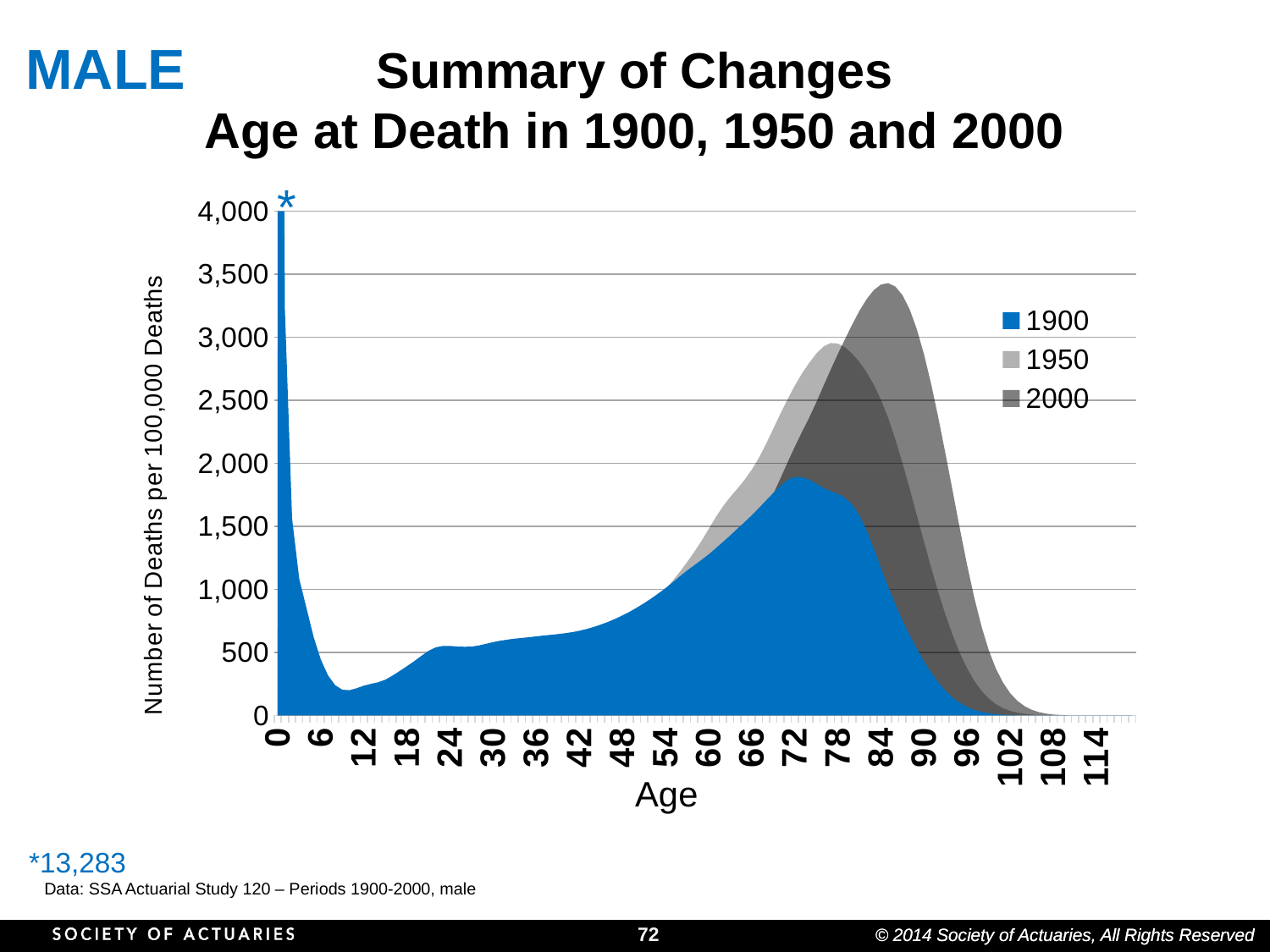
What is the label of the vertical axis? Number of Deaths per 100,000 Deaths Which series has the lowest peak value? 1950 For the 1900 series, do values rise or fall between age 0 and age 6? fall Is the value for the 1900 series at age 12 greater or less than 500? less Which series reaches its peak at the oldest age? 2000 What value does the asterisk at age 0 for the 1900 series represent, according to the footnote? 13,283 What kind of chart is shown on the slide? area chart Is the peak value of the 1950 series greater or less than 2,500? greater Is the peak value of the 1900 series (around age 72) greater or less than 2,000? less Which series has the highest peak value? 1900 How many series does the legend list? 3